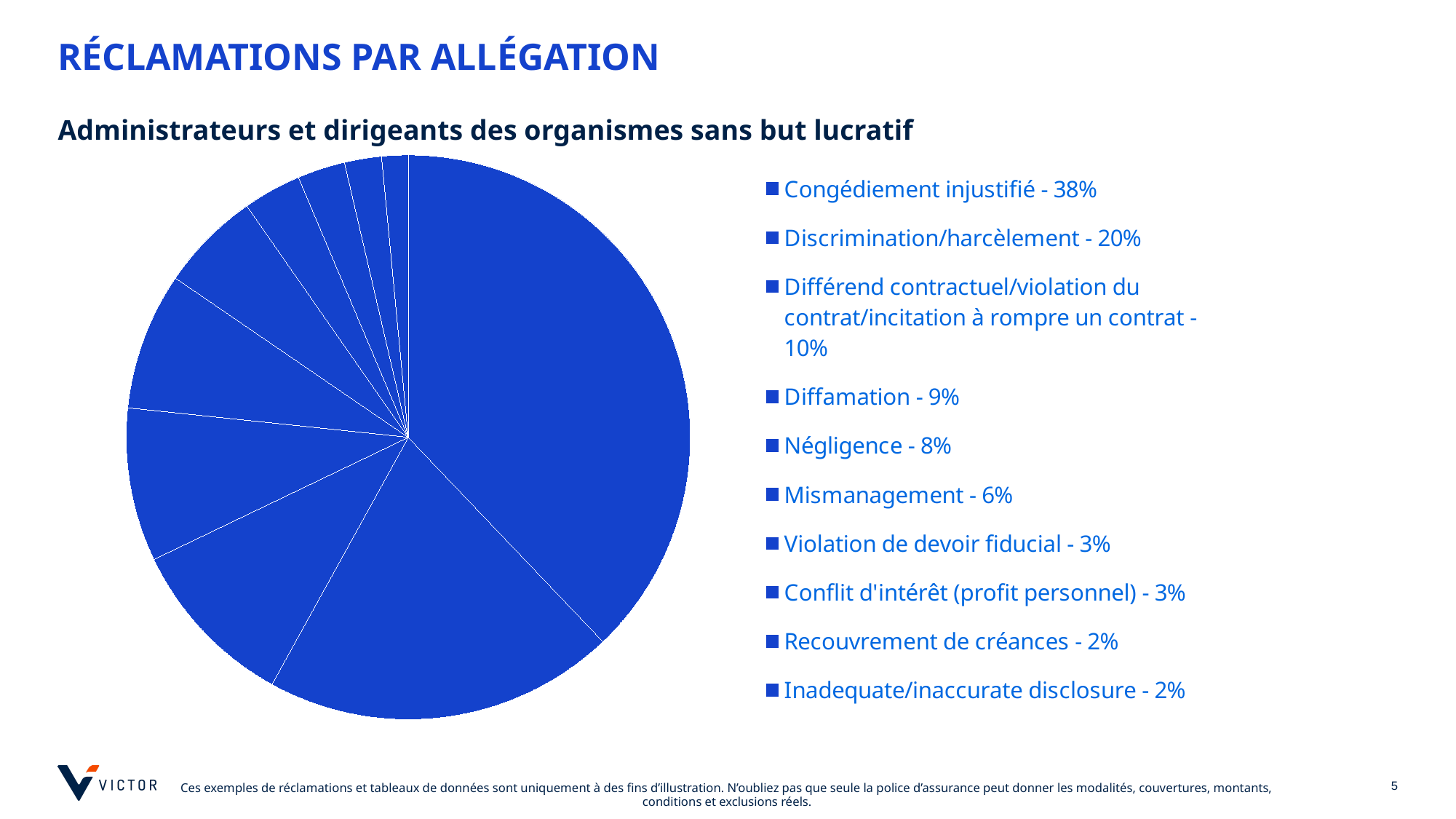
What percentage is shown for Recouvrement de créances? 2% Which is larger, the share for Diffamation or the share for Négligence? Diffamation Which allegation category has the largest share of the pie? Congédiement injustifié What is the subtitle shown above the pie chart? Administrateurs et dirigeants des organismes sans but lucratif What percentage is shown for Mismanagement? 6% What share of claims is attributed to Congédiement injustifié? 38% Which is larger, the share for Négligence or the share for Mismanagement? Négligence How many allegation categories are shown in the pie chart? 10 What kind of chart is shown on the slide? pie chart What percentage is shown for Diffamation? 9% What percentage is shown for Discrimination/harcèlement? 20% What is the difference in percentage points between Congédiement injustifié and Discrimination/harcèlement? 18